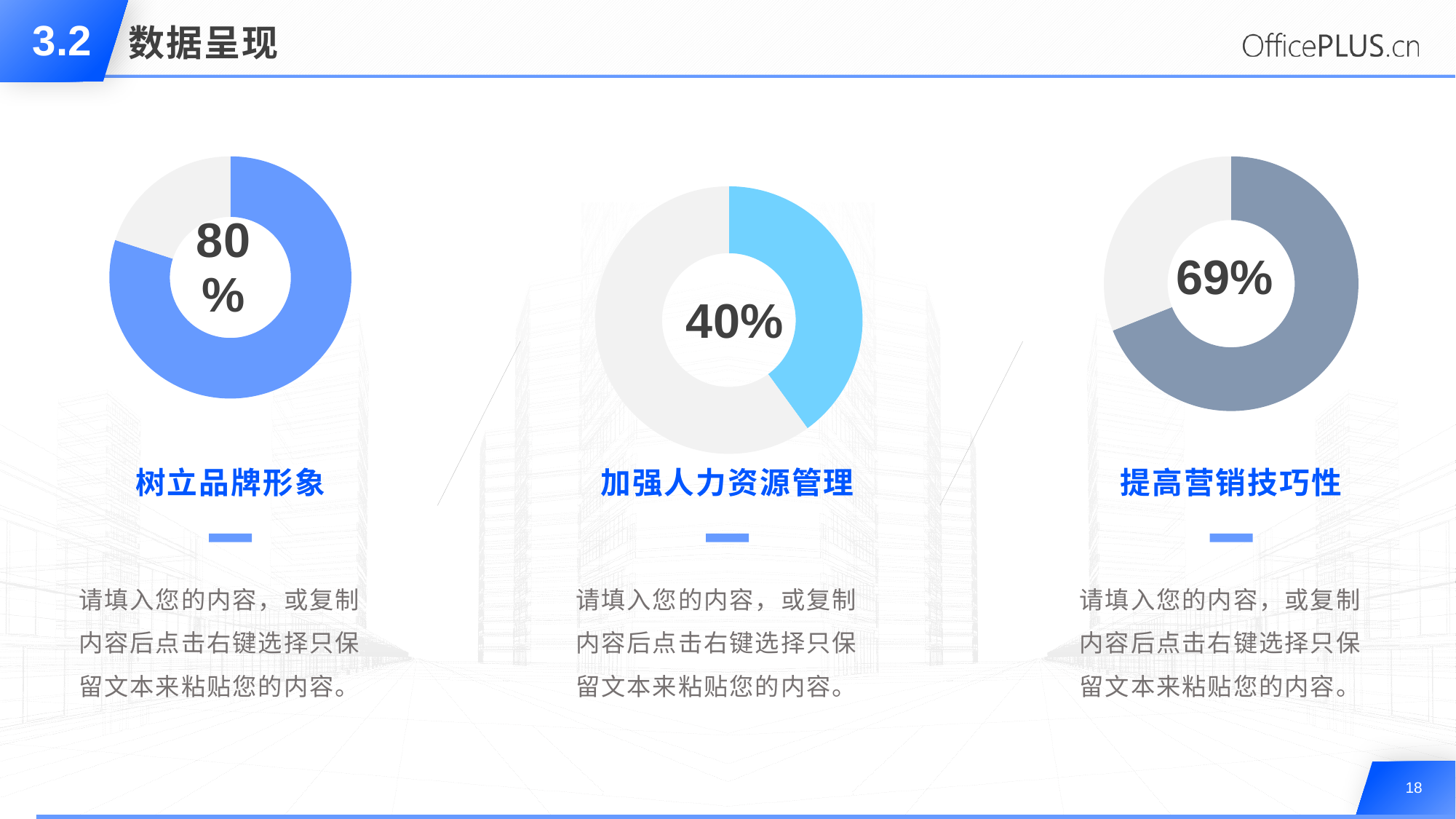
What is the difference between the percentage in the 树立品牌形象 chart and the percentage in the 加强人力资源管理 chart? 40% Which is larger: the percentage in the 提高营销技巧性 chart or the percentage in the 加强人力资源管理 chart? 提高营销技巧性 What is the difference between the percentage in the 树立品牌形象 chart and the percentage in the 提高营销技巧性 chart? 11% How many donut charts are shown on the slide? 3 What percentage is shown in the centre of the donut chart labelled 树立品牌形象? 80% What colour is the filled portion of the rightmost donut chart (提高营销技巧性)? Grey-blue What percentage is shown in the centre of the donut chart labelled 提高营销技巧性? 69% Which of the three donut charts shows the lowest percentage? 加强人力资源管理 What type of chart is used for the 加强人力资源管理 figure? Donut chart What percentage is shown in the centre of the donut chart labelled 加强人力资源管理? 40% Which of the three donut charts shows the highest percentage? 树立品牌形象 What is the title of the slide? 数据呈现